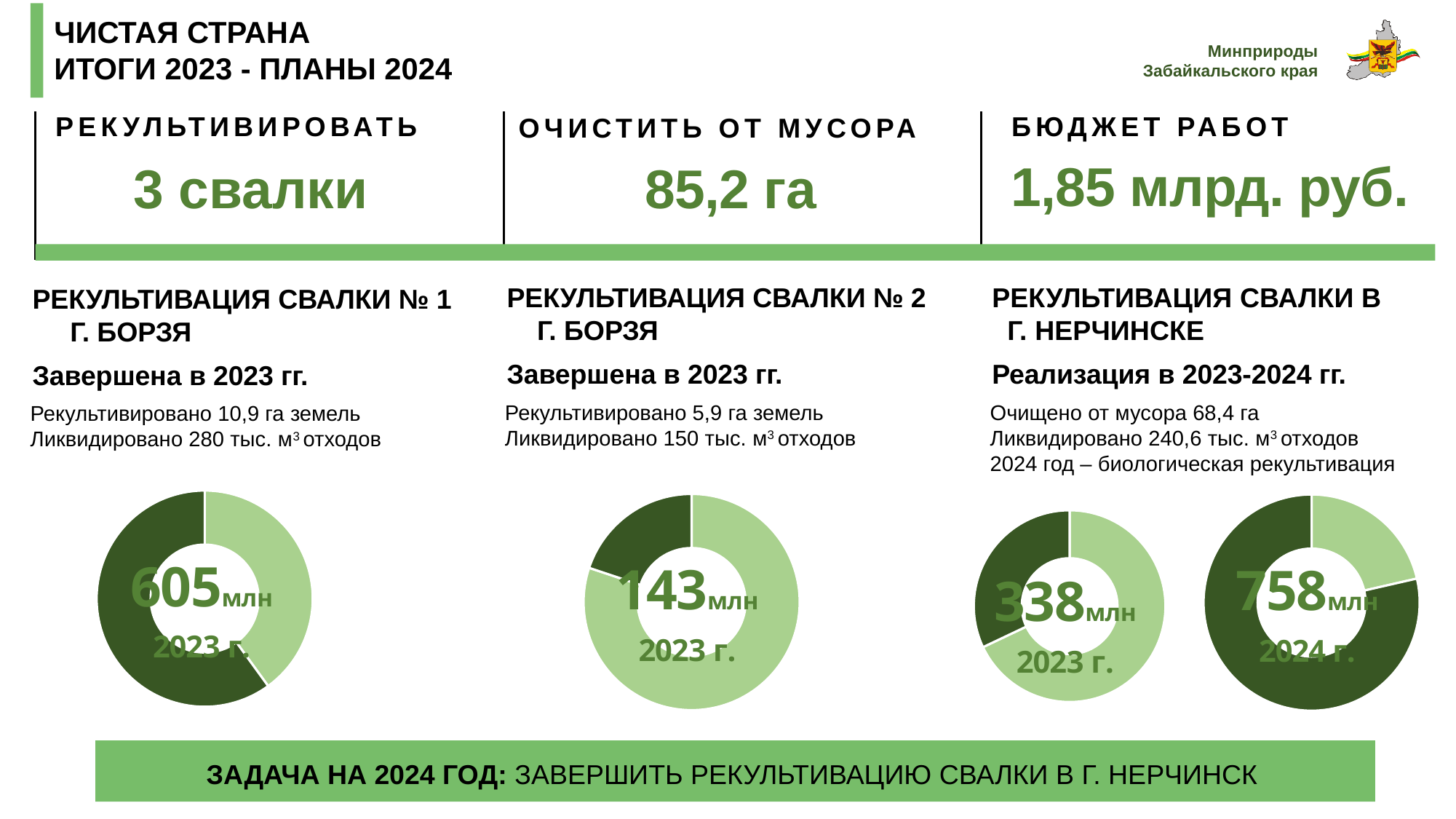
For Нерчинск, what is the difference between the 2024 г. centre value and the 2023 г. centre value? 420 млн What is the difference between the centre values of the two Борзя donut charts (605 млн and 143 млн)? 462 млн What kind of chart is used under the heading 'РЕКУЛЬТИВАЦИЯ СВАЛКИ № 1 Г. БОРЗЯ'? Donut (pie) chart How many slices does each donut chart on the slide have? 2 Which of the four donut charts shows the smallest centre value? The chart for свалка № 2 г. Борзя (143 млн) In the donut chart under 'РЕКУЛЬТИВАЦИЯ СВАЛКИ № 2 Г. БОРЗЯ', what value is printed in the centre? 143 млн Under 'РЕКУЛЬТИВАЦИЯ СВАЛКИ В Г. НЕРЧИНСКЕ', what value is printed in the centre of the donut chart labelled 2023 г.? 338 млн How many donut charts are shown on the slide? 4 Under 'РЕКУЛЬТИВАЦИЯ СВАЛКИ В Г. НЕРЧИНСКЕ', what value is printed in the centre of the donut chart labelled 2024 г.? 758 млн Which is larger: the centre value of the Нерчинск 2023 г. donut chart or the centre value of the свалка № 2 г. Борзя donut chart? Нерчинск 2023 г. (338 млн) In the donut chart under 'РЕКУЛЬТИВАЦИЯ СВАЛКИ № 1 Г. БОРЗЯ', what value is printed in the centre? 605 млн Which of the four donut charts shows the largest centre value? The 2024 г. chart for Нерчинск (758 млн)